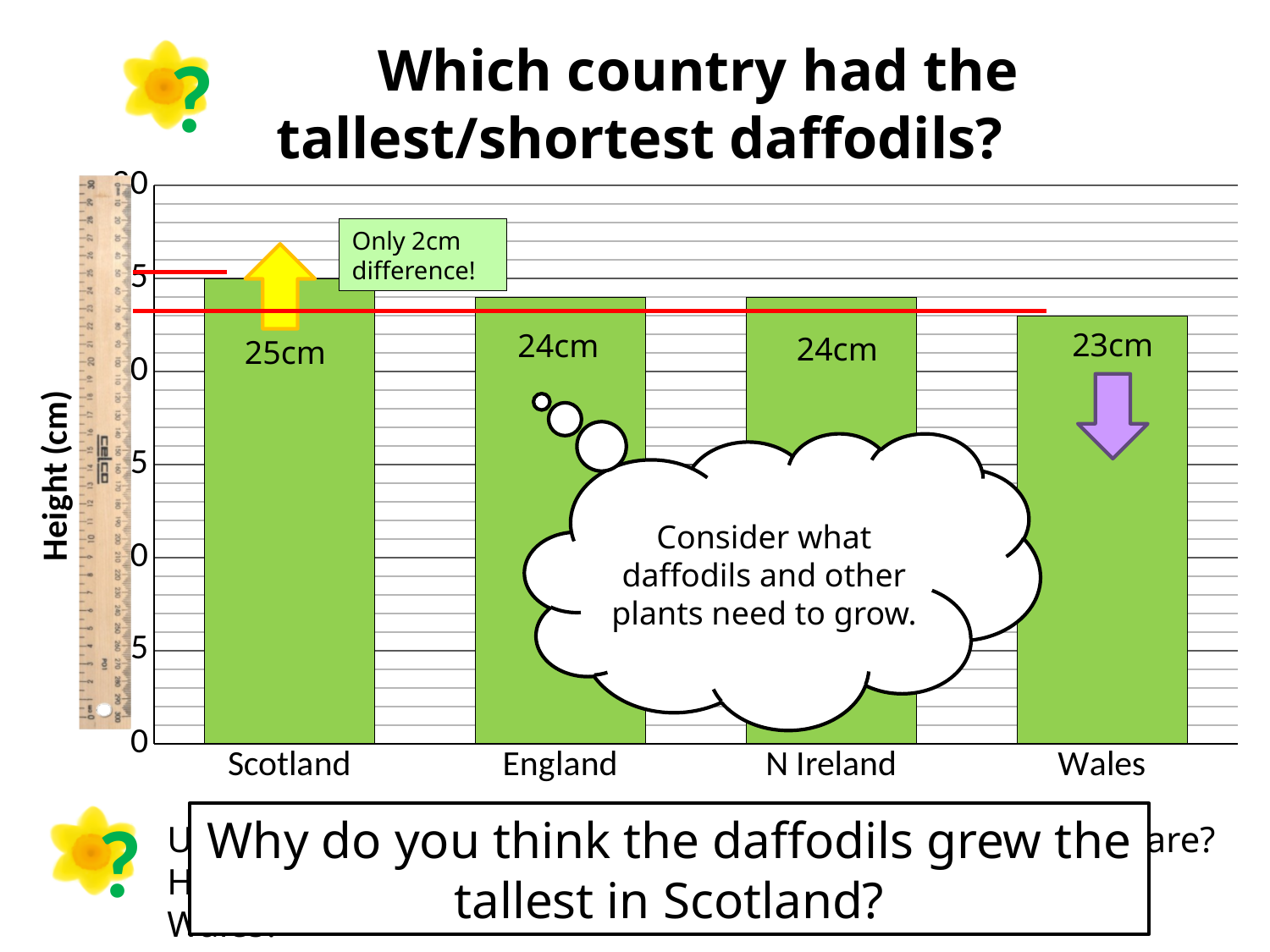
What is the label of the vertical axis? Height (cm) What is the daffodil height for N Ireland? 24cm What is the difference in daffodil height between Scotland and Wales? 2cm What kind of chart is shown on the slide? bar chart Is the value for Wales greater or less than 20? greater Which country has the shortest daffodils? Wales What is the daffodil height for Wales? 23cm What is the daffodil height for Scotland? 25cm Which country has the tallest daffodils? Scotland How many countries are shown on the chart? 4 What is the daffodil height for England? 24cm Which has taller daffodils, Scotland or England? Scotland